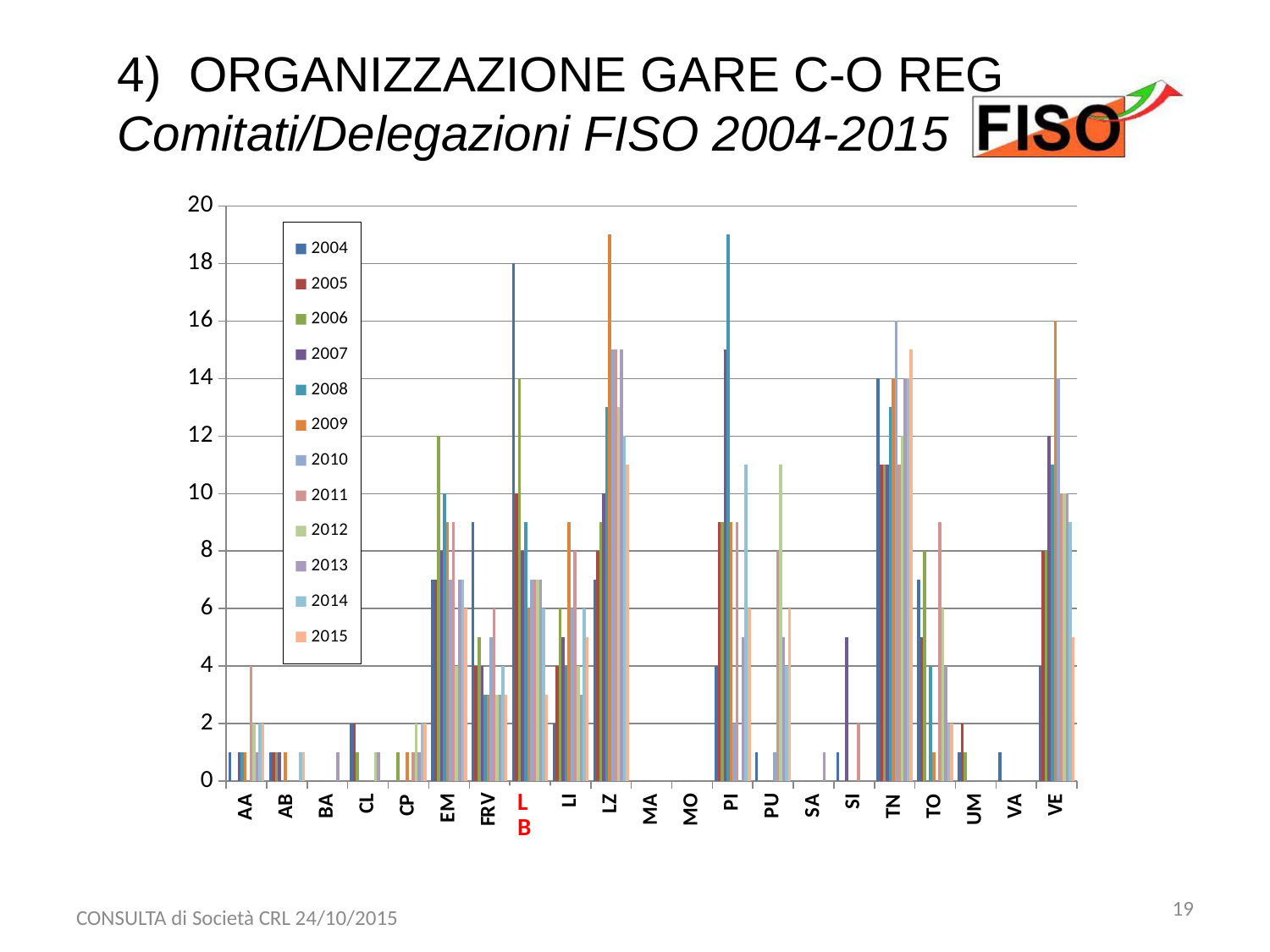
Is the value for AA in 2005 greater or less than 6? less What is the value for LB in 2004? 18 What is the first year listed in the legend? 2004 Which is larger, the value for LZ in 2009 or the value for LZ in 2004? LZ in 2009 Is the value for EM in 2006 greater or less than 10? greater Is the value for VE in 2009 greater or less than 14? greater Which category label on the x axis is written in red? LB How many series does the legend list? 12 What kind of chart is shown on the slide? bar chart How many categories are shown along the x axis? 21